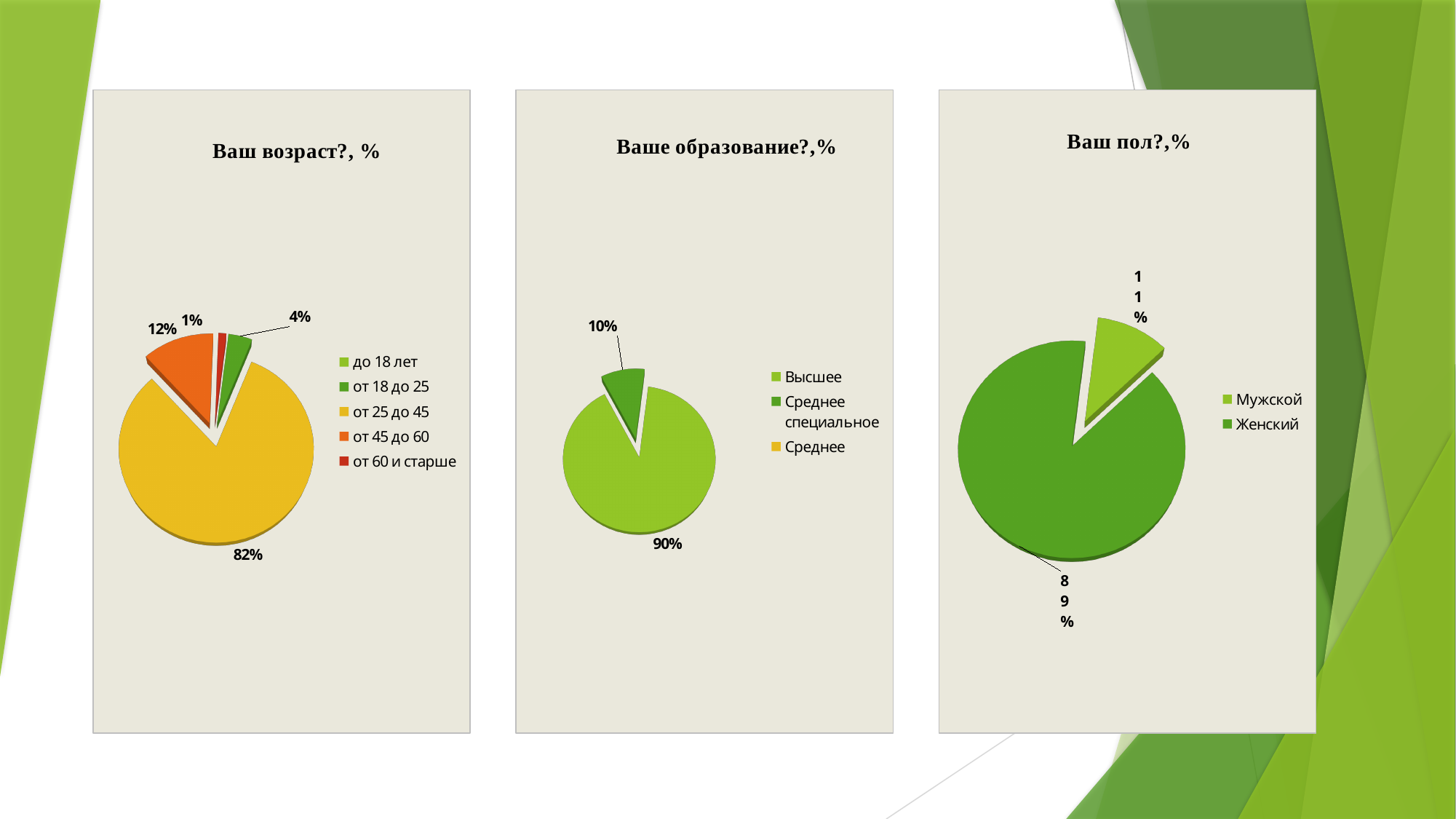
In the chart titled "Ваш возраст?, %", what share is shown for "от 45 до 60"? 12% In the chart titled "Ваш возраст?, %", what share is shown for "от 18 до 25"? 4% In the chart titled "Ваш пол?,%", what share is shown for "Женский"? 89% In the chart titled "Ваш возраст?, %", how many entries does the legend list? 5 In the chart titled "Ваше образование?,%", what share is shown for "Среднее специальное"? 10% In the chart titled "Ваш пол?,%", which is larger, "Мужской" or "Женский"? Женский In the chart titled "Ваш возраст?, %", what is the difference between the shares for "от 45 до 60" and "от 18 до 25"? 8% In the chart titled "Ваш возраст?, %", which category has the largest slice? от 25 до 45 In the chart titled "Ваше образование?,%", what share is shown for "Высшее"? 90% In the chart titled "Ваше образование?,%", how many entries does the legend list? 3 What type of chart is the chart titled "Ваш пол?,%"? Pie chart In the chart titled "Ваш возраст?, %", what share is shown for "от 25 до 45"? 82%